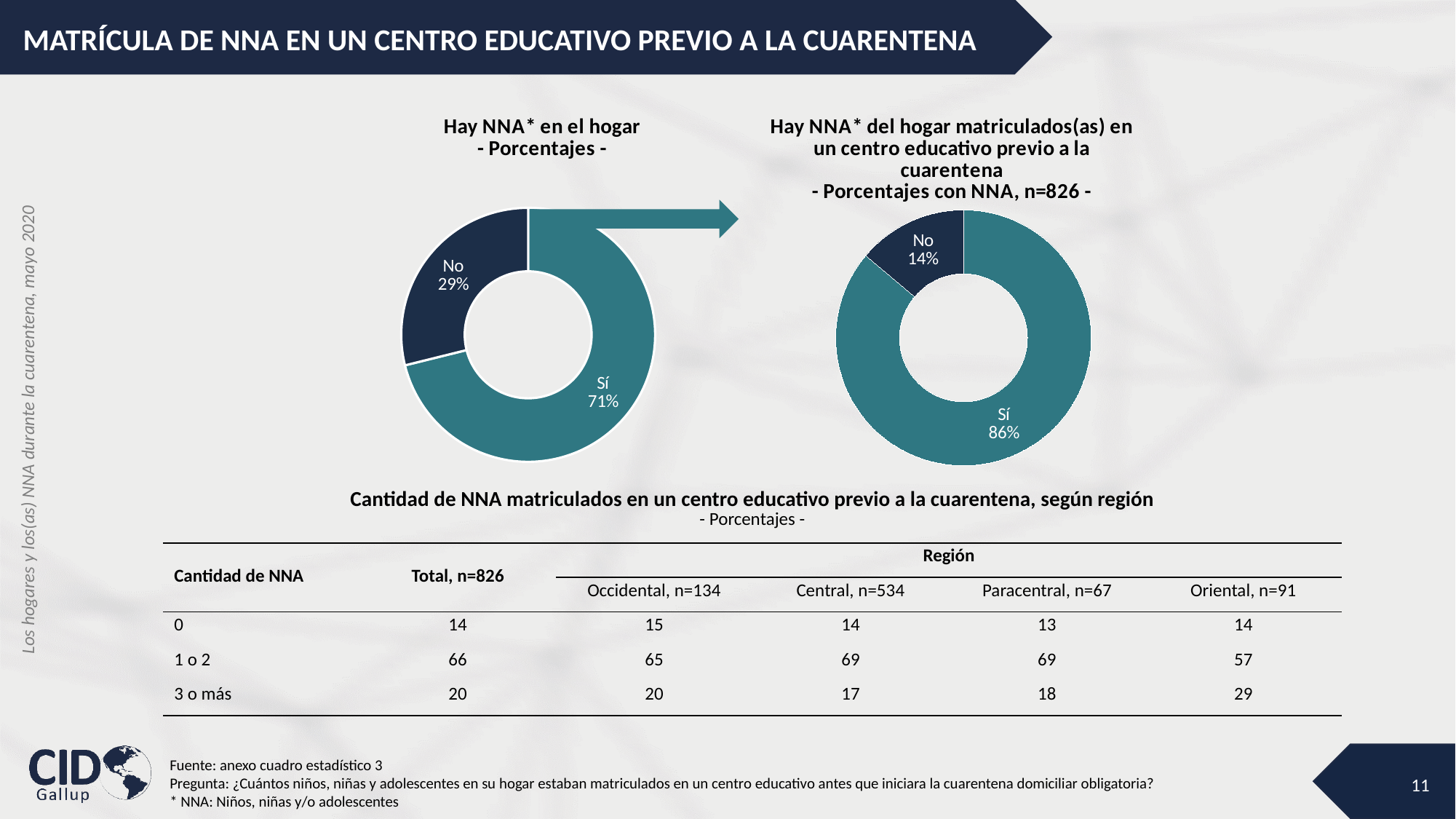
In the left chart 'Hay NNA* en el hogar', what is the difference in percentage points between 'Sí' and 'No'? 42 In the right chart 'Hay NNA* del hogar matriculados(as) en un centro educativo previo a la cuarentena', what percentage is shown for 'No'? 14% In the right chart 'Hay NNA* del hogar matriculados(as)', which category has the smallest share? No What type of chart is the right chart 'Hay NNA* del hogar matriculados(as)'? Donut (pie) chart In the right chart 'Hay NNA* del hogar matriculados(as) en un centro educativo previo a la cuarentena', what percentage is shown for 'Sí'? 86% In the left chart 'Hay NNA* en el hogar', which category has the largest share? Sí What sample size (n) is stated in the title of the right chart? n=826 Is the 'Sí' share larger in the left chart 'Hay NNA* en el hogar' or in the right chart 'Hay NNA* del hogar matriculados(as)'? Right chart How many categories does the left chart 'Hay NNA* en el hogar' show? 2 In the right chart 'Hay NNA* del hogar matriculados(as)', what is the difference in percentage points between 'Sí' and 'No'? 72 In the left chart 'Hay NNA* en el hogar', what percentage is shown for 'No'? 29% In the left chart 'Hay NNA* en el hogar', what percentage is shown for 'Sí'? 71%